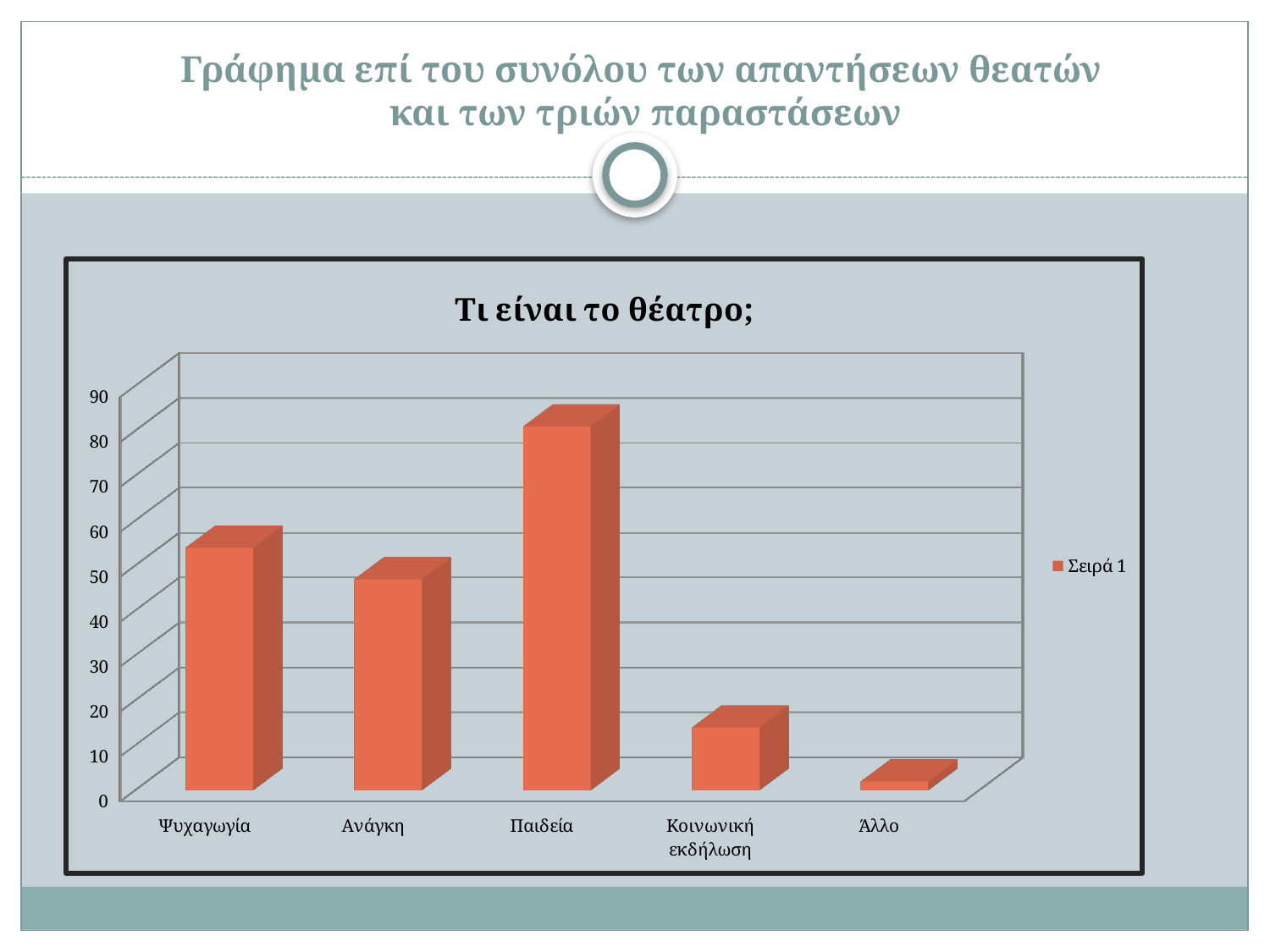
Is the value for Κοινωνική εκδήλωση greater or less than 20? less Is the value for Παιδεία greater or less than 70? greater What is the name of the series shown in the legend? Σειρά 1 Is the value for Ψυχαγωγία greater or less than 40? greater Which is larger, the value for Κοινωνική εκδήλωση or the value for Παιδεία? Παιδεία What kind of chart is shown on the slide? bar chart Which category has the lowest value? Άλλο Which category has the highest value? Παιδεία What is the title of the chart? Τι είναι το θέατρο; How many series does the legend list? 1 Which is larger, the value for Ψυχαγωγία or the value for Ανάγκη? Ψυχαγωγία How many categories are shown on the x axis of the chart? 5